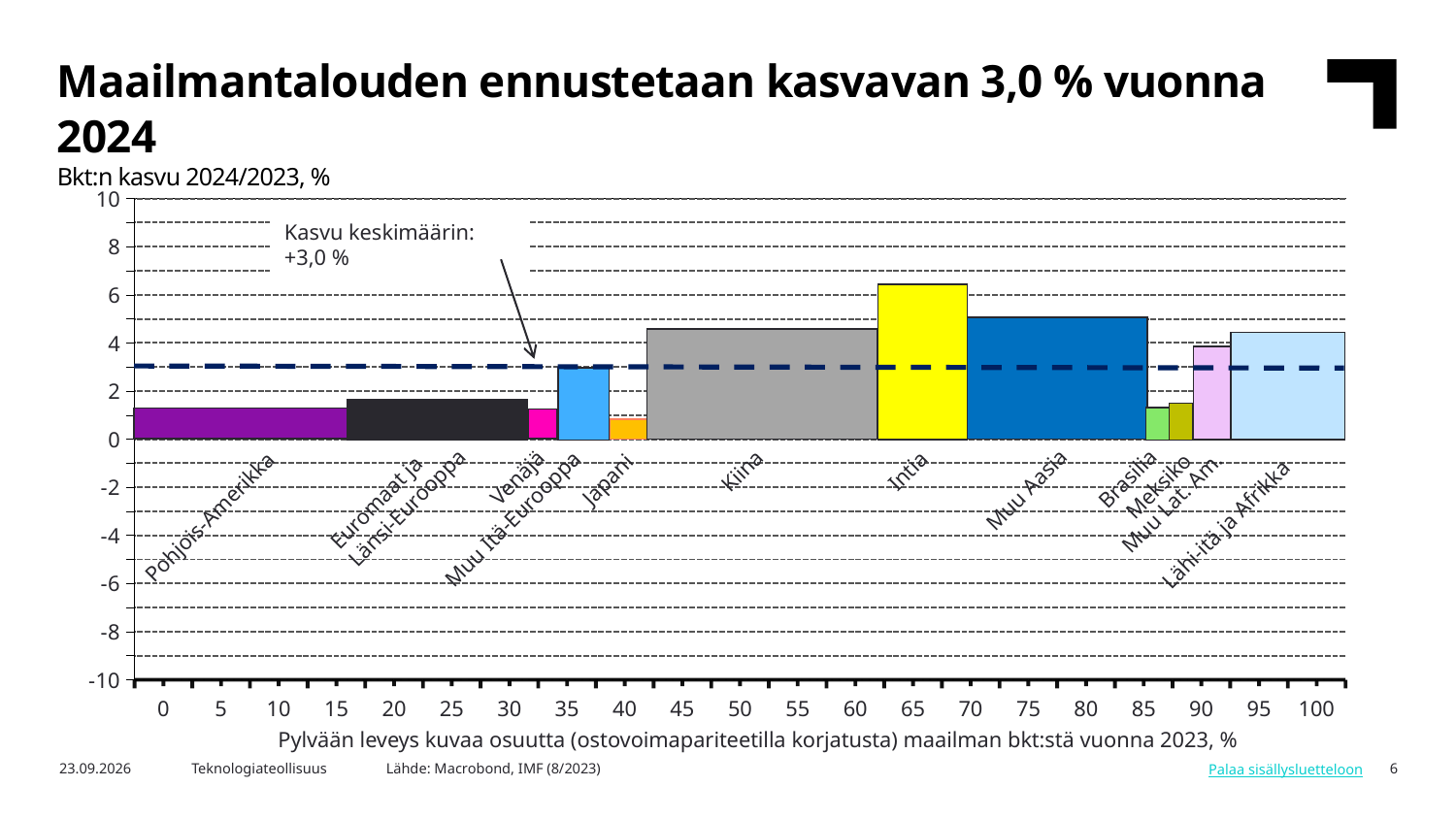
How many regions (bars) are shown in the chart? 12 Is the value for Intia greater or less than 6? greater What kind of chart is shown on the slide? bar chart What average growth value is annotated on the chart (Kasvu keskimäärin)? +3,0 % Which region has the highest GDP growth in the chart? Intia According to the note below the x axis, what does the width of each bar represent? Share of world GDP (PPP-adjusted) in 2023, % Is the value for Pohjois-Amerikka greater or less than 2? less Which has the higher GDP growth, Intia or Kiina? Intia Is the value for Muu Aasia greater or less than 4? greater Which has the higher GDP growth, Kiina or Euromaat ja Länsi-Eurooppa? Kiina